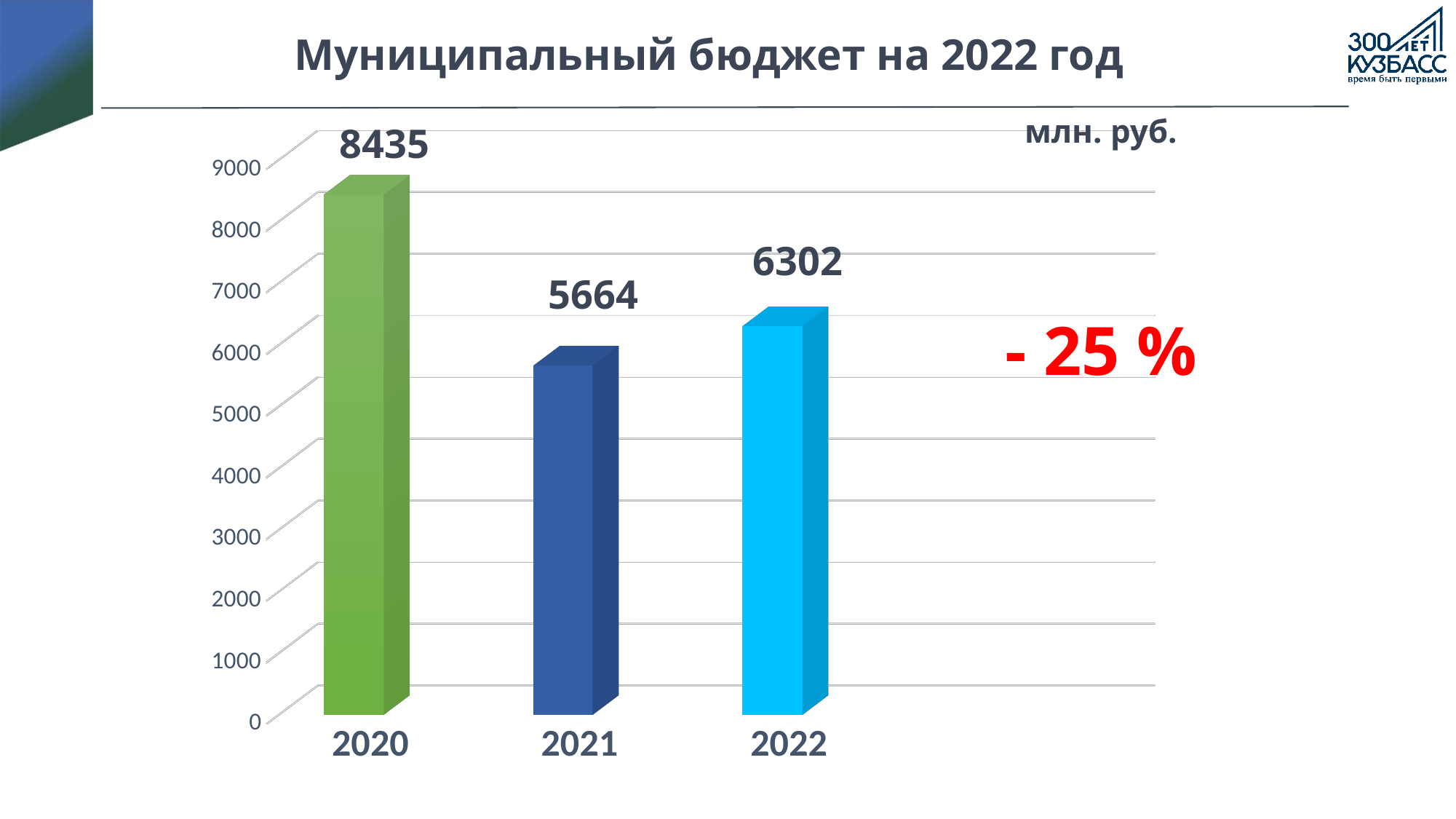
What is the value for 2022? 6302 What is the value for 2021? 5664 What is the difference between the values for 2022 and 2021? 638 Which year has the lowest value? 2021 What kind of chart is shown on the slide? bar chart Which is larger, the value for 2021 or the value for 2022? 2022 What unit is indicated for the chart values? млн. руб. What is the value for 2020? 8435 What is the difference between the values for 2020 and 2022? 2133 How many years are shown on the chart? 3 Which year has the highest value? 2020 Is the value for 2021 greater or less than 6000? less